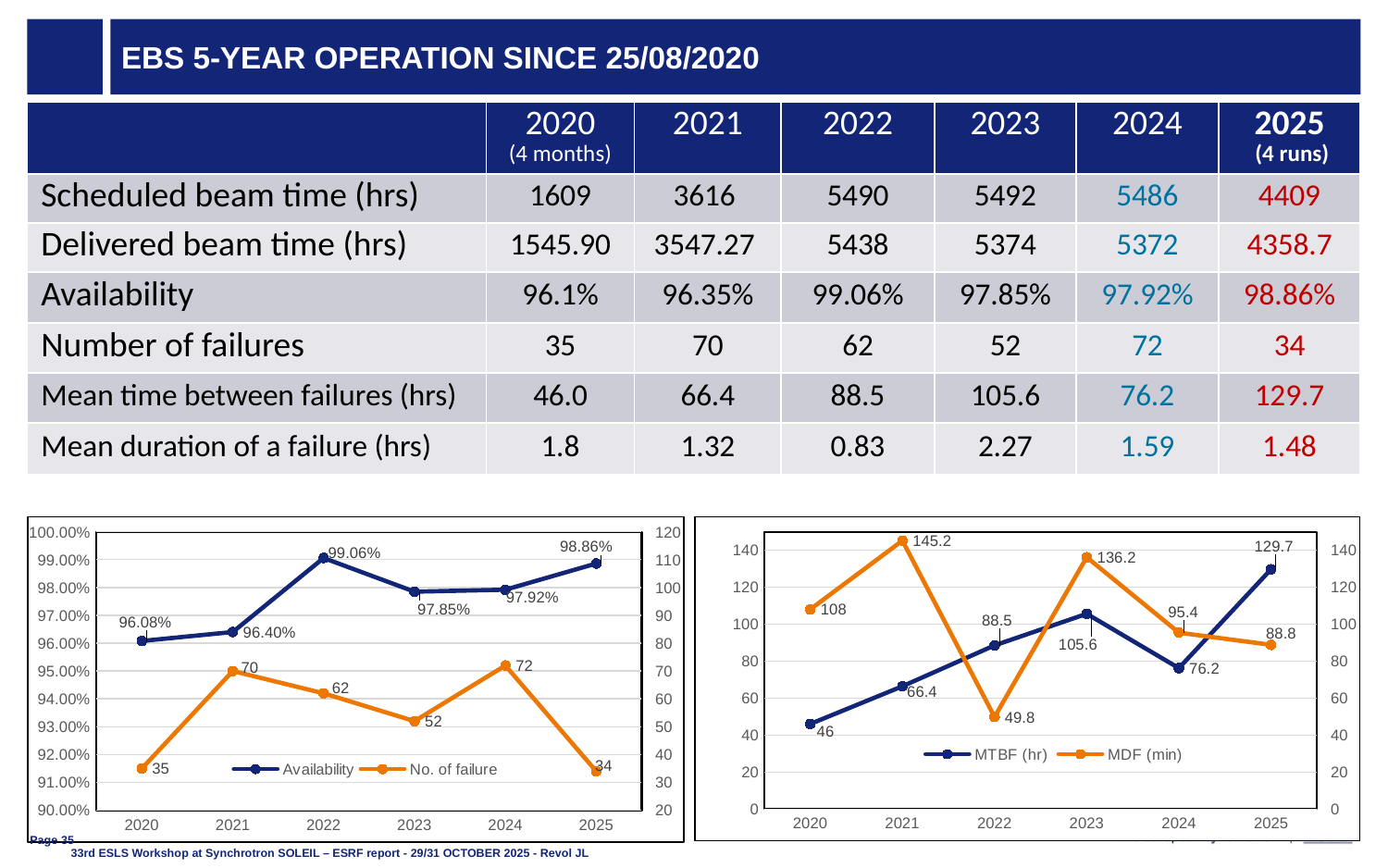
In the left chart, what is the No. of failure value for 2024? 72 In the left chart, which year has the lowest Availability? 2020 In the right chart, what is the difference between the MTBF (hr) values for 2025 and 2020? 83.7 In the right chart, what is the MDF (min) value for 2021? 145.2 In the left chart, what is the difference between the No. of failure in 2021 and in 2025? 36 In the right chart, which is larger in 2024: MTBF (hr) or MDF (min)? MDF (min) In the right chart, what is the MTBF (hr) value for 2023? 105.6 In the left chart, how many series does the legend list? 2 In the left chart, which year has the highest No. of failure? 2024 In the left chart, what is the Availability value shown for 2022? 99.06% What type of chart is the right chart? Line chart In the right chart, which year has the lowest MDF (min)? 2022